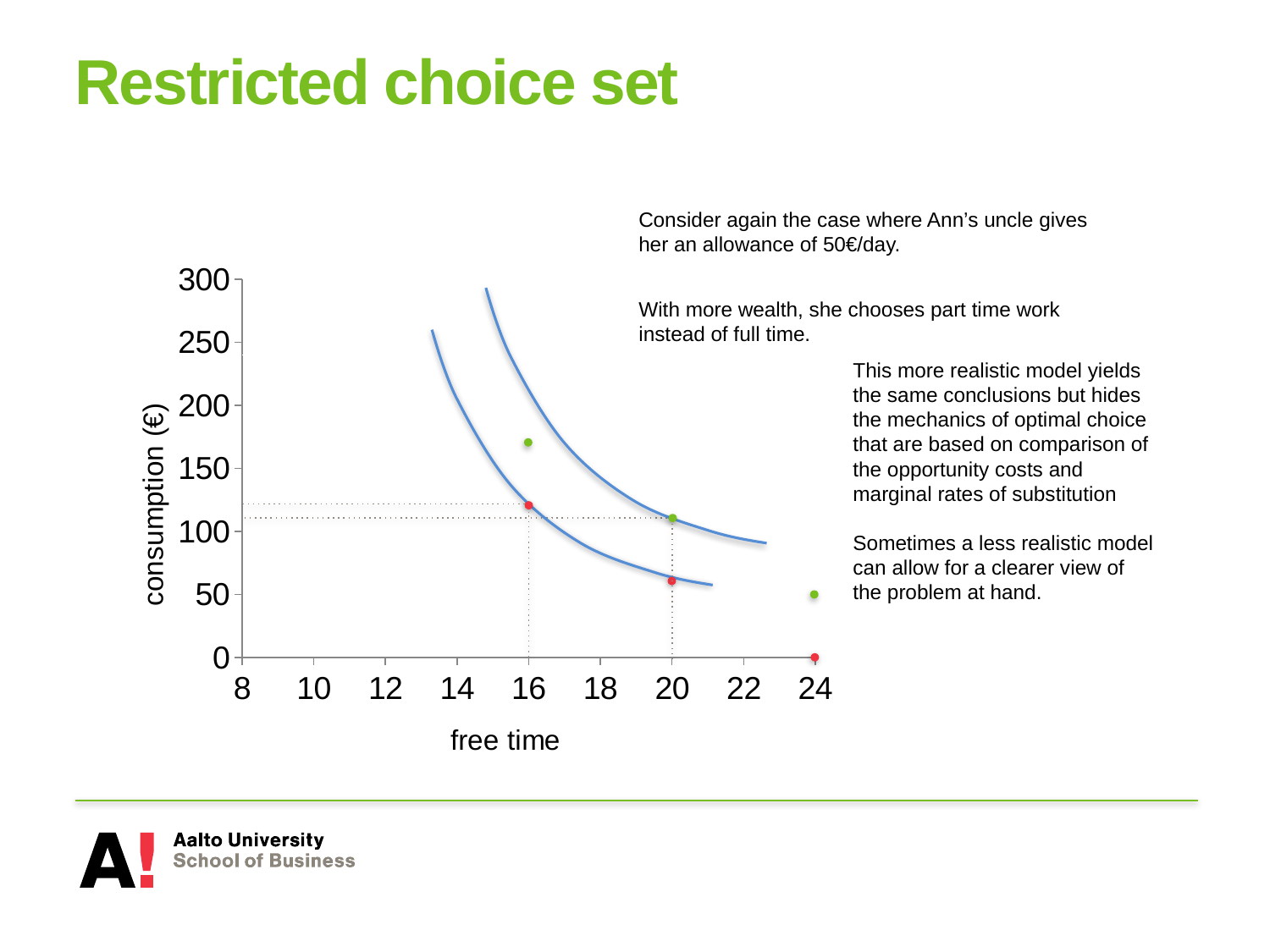
How many blue curves are drawn on the chart? 2 What is the label of the horizontal axis? free time Is the consumption value of the green dot at free time 24 greater or less than 100? less At free time 16, which dot has the higher consumption, the green one or the red one? the green one Is the consumption value of the green dot at free time 16 greater or less than 150? greater Is the consumption value of the red dot at free time 20 greater or less than 100? less How many dots (data points) are plotted on the chart? 6 What is the label of the vertical axis? consumption (€) What kind of chart is shown on the slide? scatter chart with curves Do the blue curves rise or fall as free time increases? fall Which dot has the lowest consumption value on the chart? the red dot at free time 24 What is the consumption value of the red dot at free time 24? 0